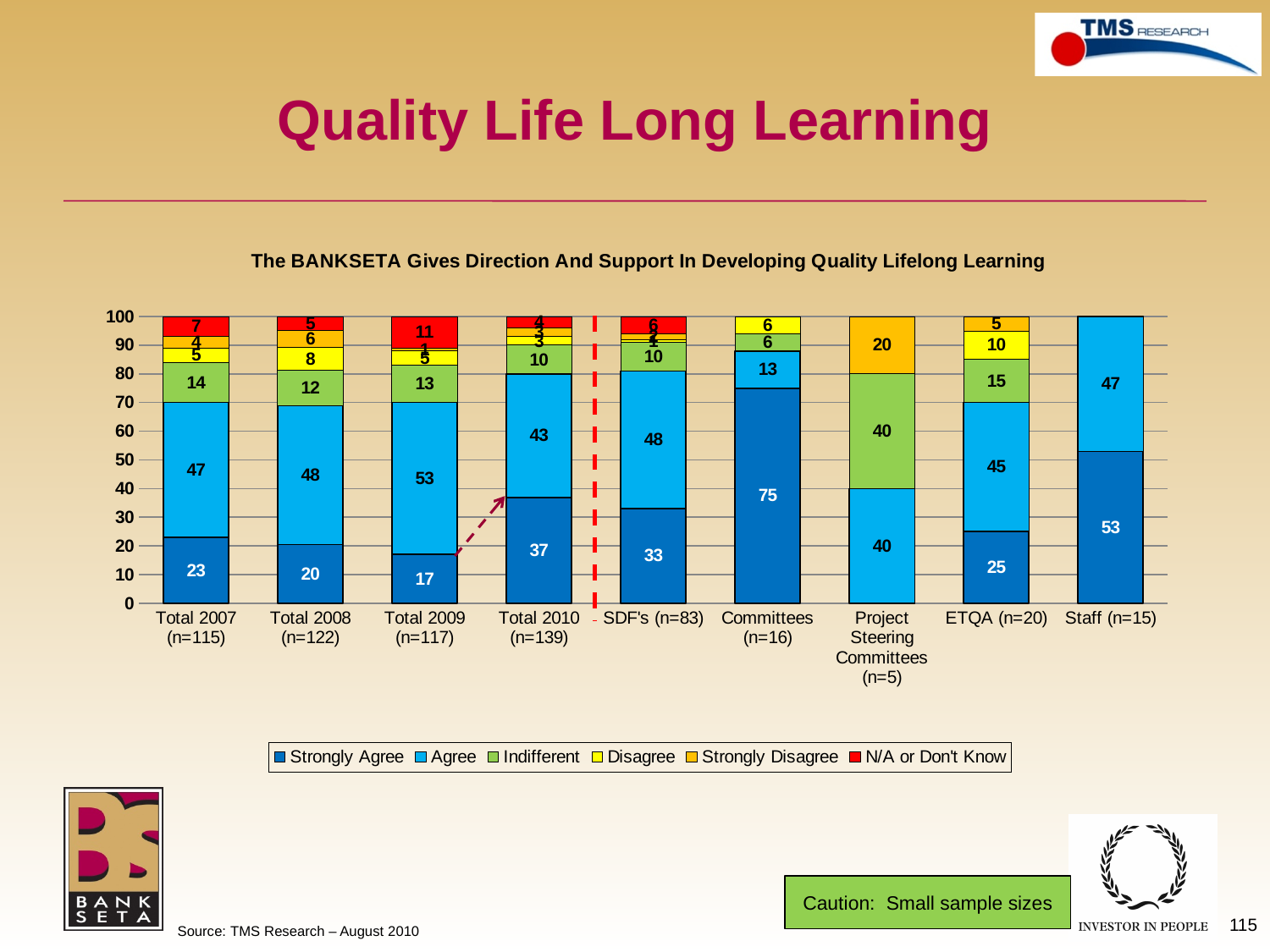
What is the Agree value for Staff (n=15)? 47 What is the Agree value for Total 2009 (n=117)? 53 How many categories are shown on the x axis? 9 What kind of chart is this? Stacked bar chart Which category has the highest Strongly Agree value? Committees (n=16) What is the Strongly Agree value for Committees (n=16)? 75 What is the difference between the Strongly Agree values for Total 2010 (n=139) and Total 2009 (n=117)? 20 What is the Indifferent value for Project Steering Committees (n=5)? 40 How many series does the legend list? 6 From Total 2007 to Total 2009, does the Strongly Agree value rise or fall? Fall Which has the larger Agree value, Total 2007 (n=115) or Total 2008 (n=122)? Total 2008 (n=122)